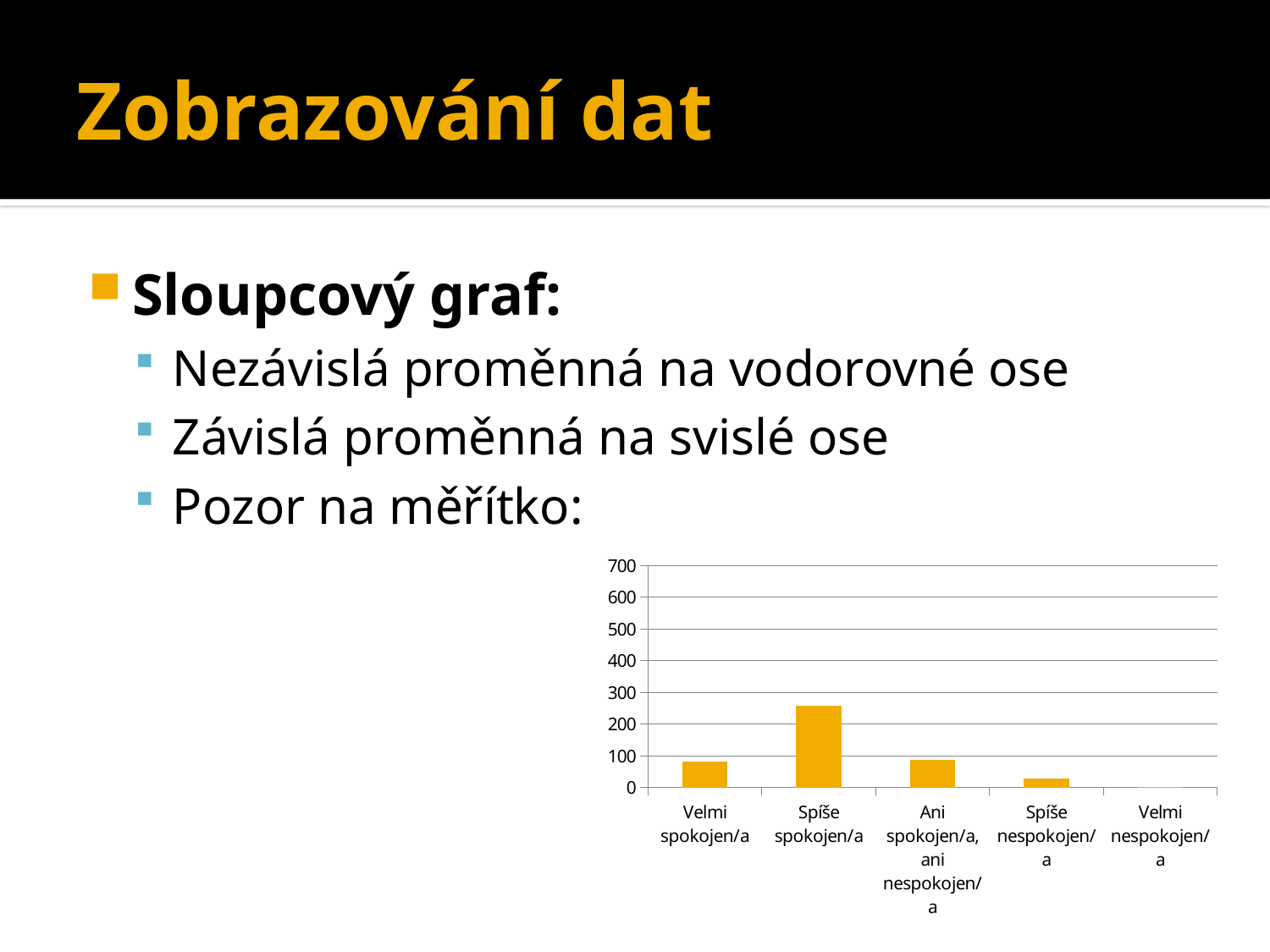
Is the value for Velmi spokojen/a greater or less than 100? less What colour are the bars in the chart? orange Which category has the highest bar in the chart? Spíše spokojen/a Which category has the lowest bar in the chart? Velmi nespokojen/a How many categories are shown on the x axis of the chart? 5 Which is larger, the value for Ani spokojen/a, ani nespokojen/a or the value for Velmi nespokojen/a? Ani spokojen/a, ani nespokojen/a What is the highest value shown on the vertical axis of the chart? 700 What kind of chart is shown on the slide? bar chart Is the value for Spíše spokojen/a greater or less than 200? greater Is the value for Spíše spokojen/a greater or less than 300? less Which is larger, the value for Spíše spokojen/a or the value for Spíše nespokojen/a? Spíše spokojen/a